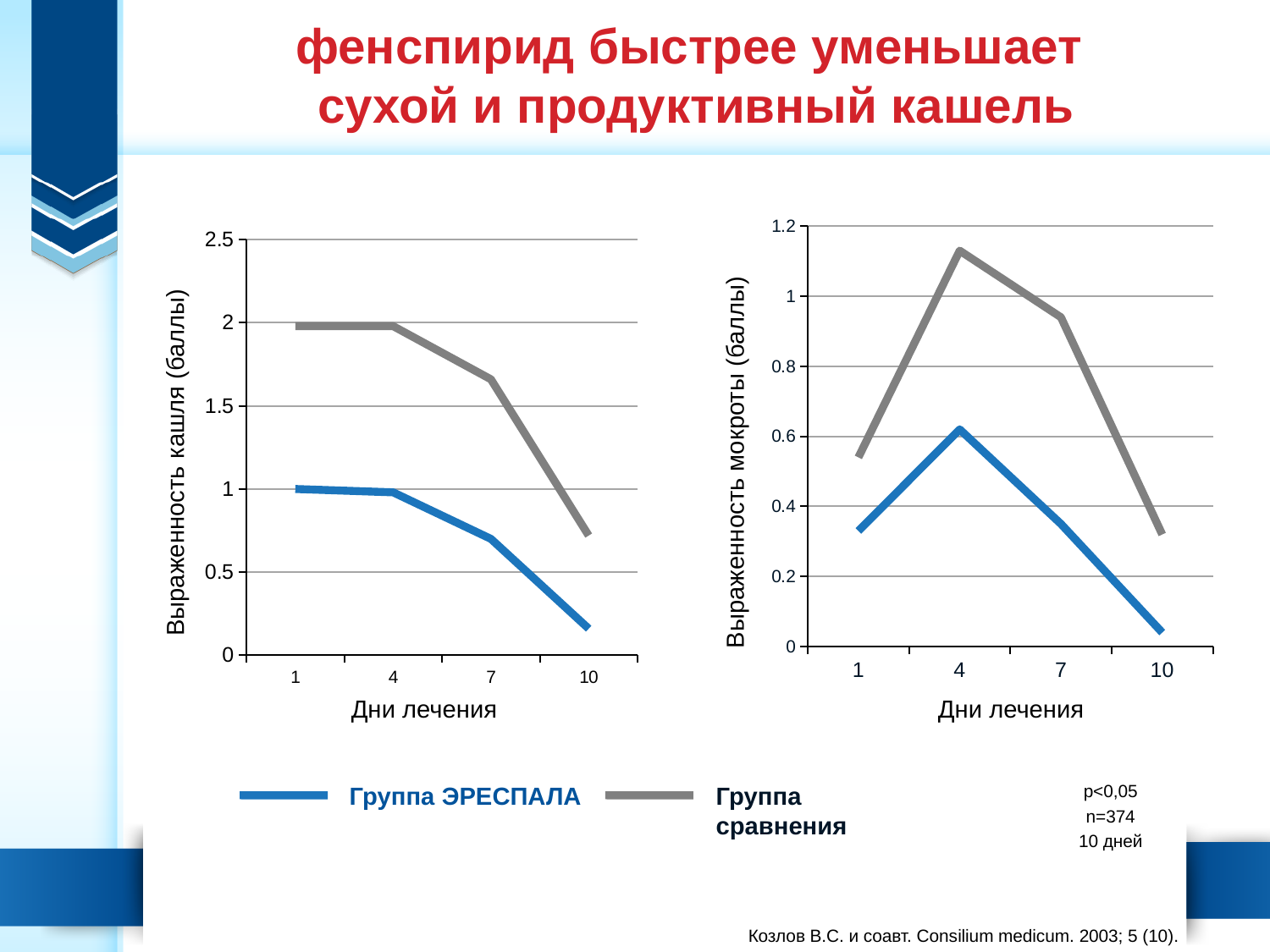
On the right chart (Выраженность мокроты), which group has the lower value on day 7? Группа ЭРЕСПАЛА On the left chart (Выраженность кашля), is the value for Группа сравнения on day 7 greater or less than 1.5? greater On the left chart (Выраженность кашля), how many days of treatment are marked on the x axis? 4 What colour is the line for Группа ЭРЕСПАЛА in the legend? blue On the right chart (Выраженность мокроты), is the value for Группа сравнения on day 4 greater or less than 1? greater On the right chart (Выраженность мокроты), is the value for Группа ЭРЕСПАЛА on day 4 greater or less than 0.5? greater How many series does the legend list? 2 On the right chart (Выраженность мокроты), on which day does Группа сравнения reach its highest value? 4 What kind of chart is the left chart (Выраженность кашля)? line chart On the left chart (Выраженность кашля), which group has the higher value on day 10? Группа сравнения On the left chart (Выраженность кашля), does the Группа ЭРЕСПАЛА line rise or fall from day 1 to day 10? fall